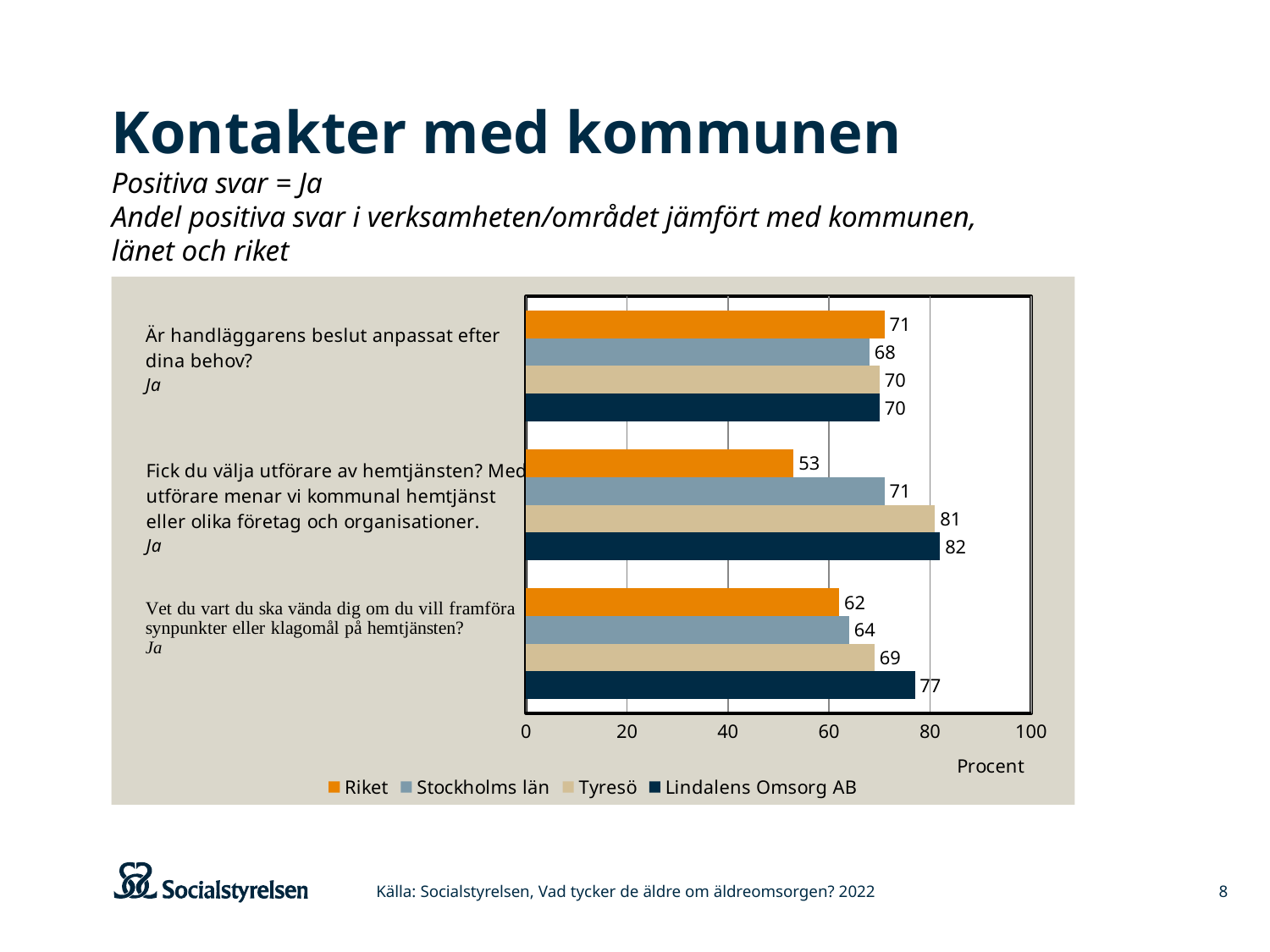
What unit is labelled on the x axis of the chart? Procent What is the difference between Lindalens Omsorg AB and Riket on the question "Fick du välja utförare av hemtjänsten?"? 29 On the question "Vet du vart du ska vända dig om du vill framföra synpunkter eller klagomål på hemtjänsten?", which is larger: Tyresö or Stockholms län? Tyresö What is the value for Riket on the question "Fick du välja utförare av hemtjänsten?"? 53 Which series has the lowest value on the question "Vet du vart du ska vända dig om du vill framföra synpunkter eller klagomål på hemtjänsten?"? Riket How many series does the legend list? 4 How many question categories are plotted on the chart? 3 What is the value for Stockholms län on the question "Är handläggarens beslut anpassat efter dina behov?"? 68 Is the value for Riket on the question "Fick du välja utförare av hemtjänsten?" greater or less than 60? less What kind of chart is shown on the slide? bar chart What is the value for Lindalens Omsorg AB on the question "Vet du vart du ska vända dig om du vill framföra synpunkter eller klagomål på hemtjänsten?"? 77 Which series has the highest value on the question "Fick du välja utförare av hemtjänsten?"? Lindalens Omsorg AB